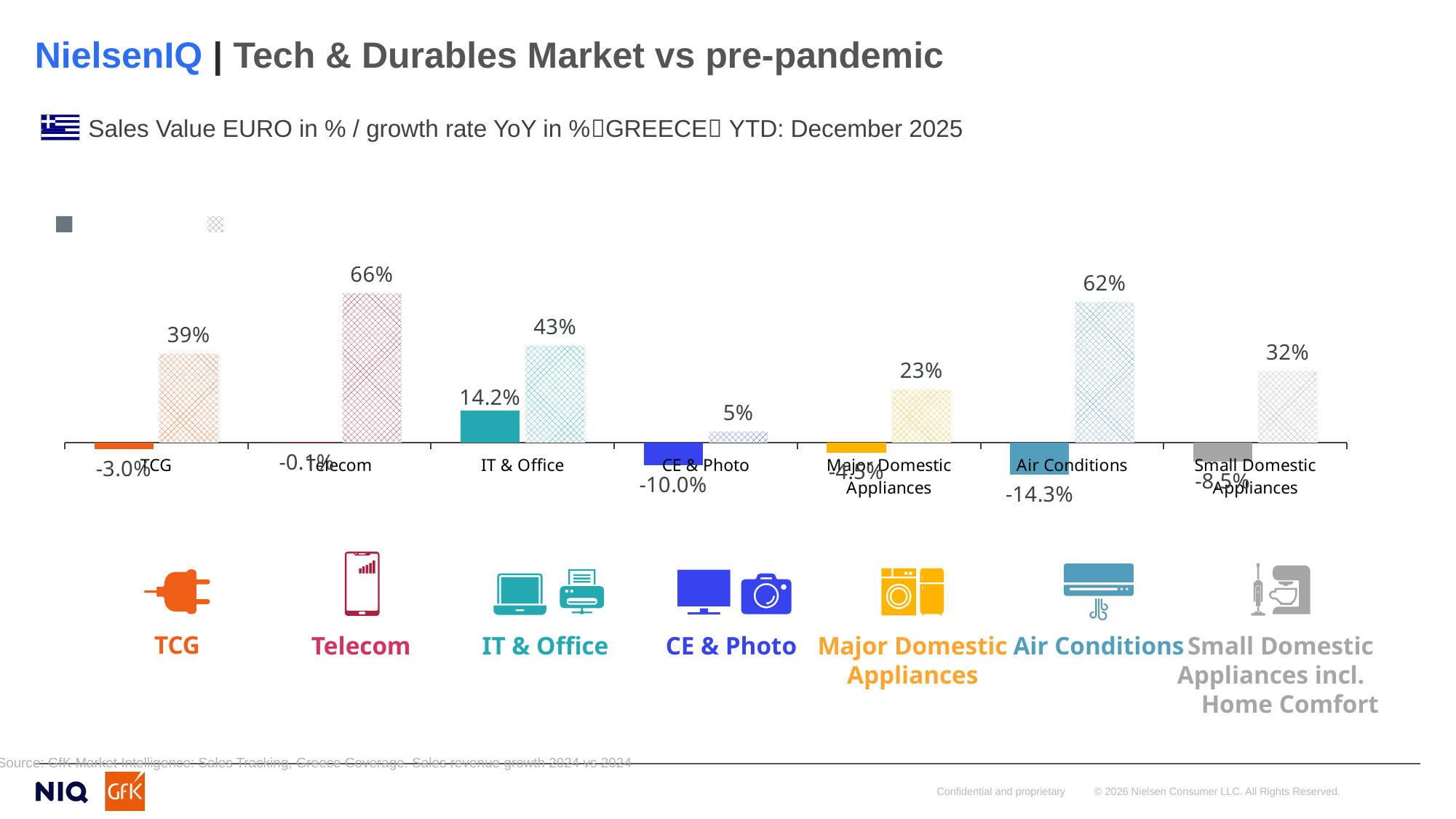
What is the value of the solid bar for CE & Photo? -10.0% What kind of chart is shown on the slide? bar chart Which category has the lowest solid bar value? Air Conditions What is the value of the solid bar for Air Conditions? -14.3% Which is larger, the hatched bar value for Major Domestic Appliances or for Small Domestic Appliances? Small Domestic Appliances How many categories are shown on the x axis of the chart? 7 What is the value of the hatched bar for CE & Photo? 5% What is the value of the solid bar for IT & Office? 14.2% What is the difference between the hatched bar values for Telecom and Air Conditions? 4% What is the value of the hatched bar for Telecom? 66% Which category has the highest hatched bar value? Telecom How many series does the chart's legend list? 2